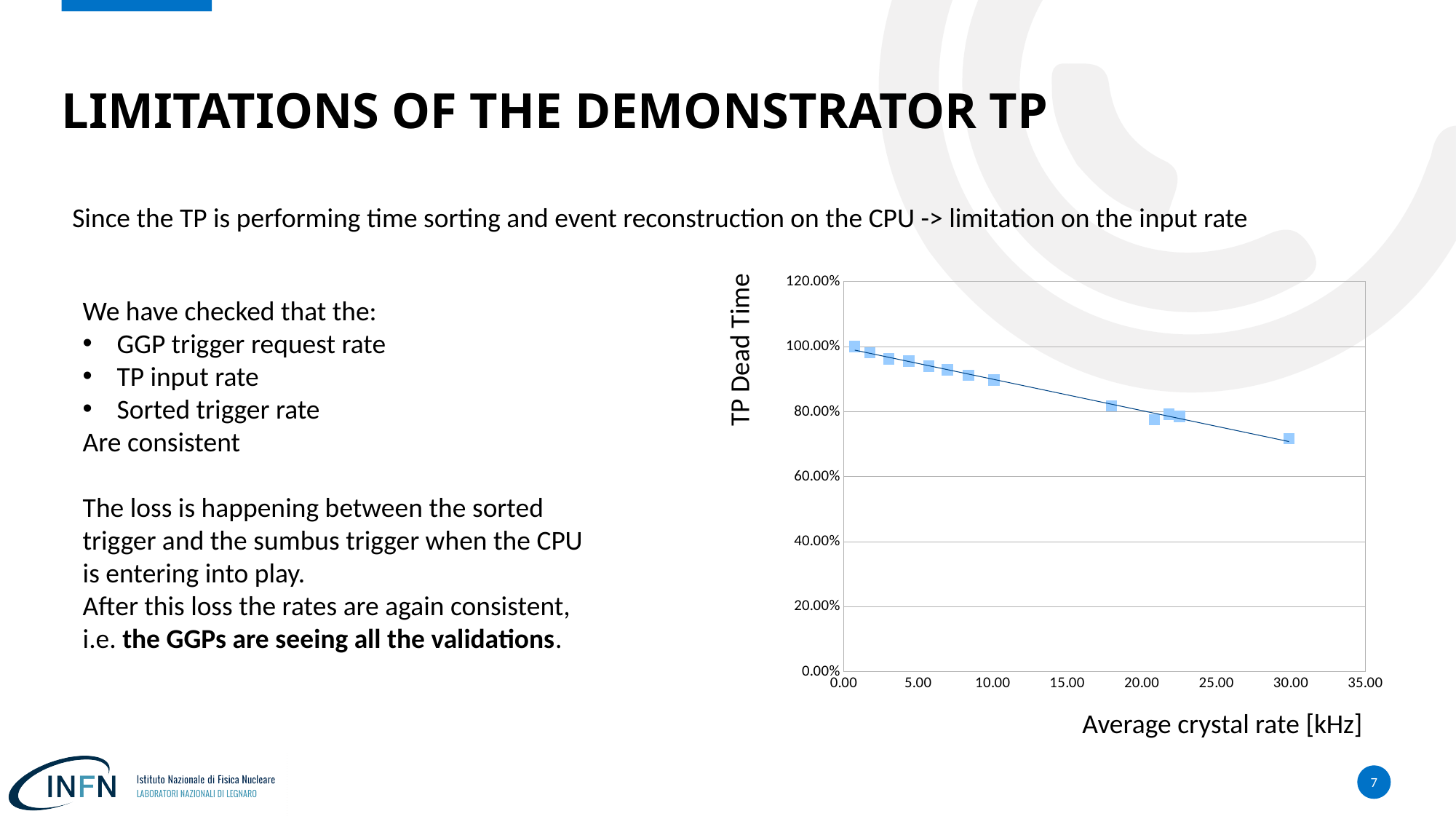
Which has the lower TP dead time: the point at about 18 kHz or the point at about 1 kHz? the point at about 18 kHz Is the TP dead time at an average crystal rate of about 10 kHz greater or less than 80.00%? greater As the average crystal rate increases along the x axis, does the TP dead time rise or fall? fall Which has the higher TP dead time: the point at about 5 kHz or the point at about 30 kHz? the point at about 5 kHz Is the TP dead time at an average crystal rate of about 21 kHz greater or less than 80.00%? less Is the TP dead time at an average crystal rate of about 30 kHz greater or less than 60.00%? greater What kind of chart is shown on the slide? scatter chart What is the maximum value shown on the y axis of the chart? 120.00% What is the label of the x axis of the chart? Average crystal rate [kHz] What is the label of the y axis of the chart? TP Dead Time